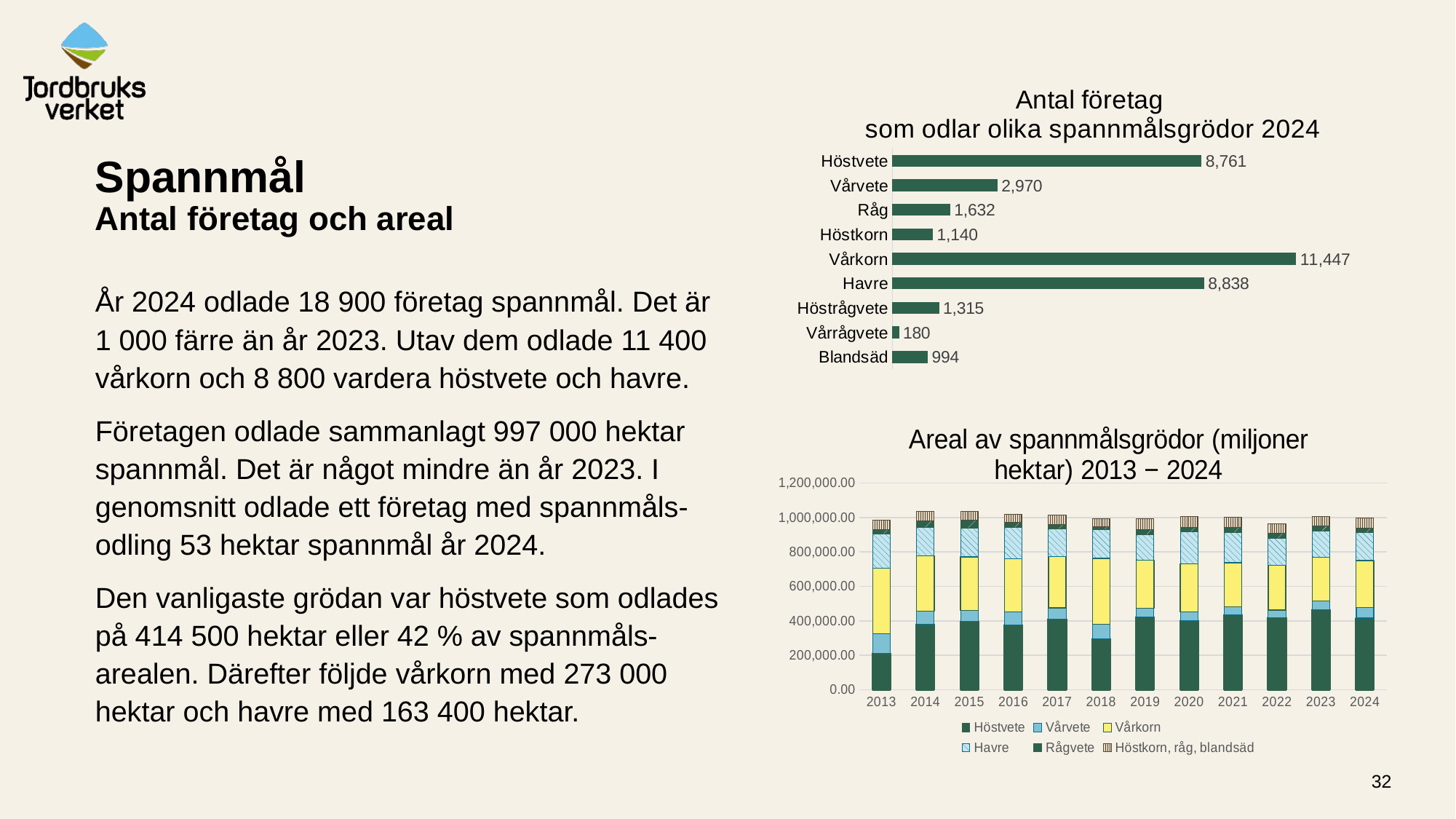
In the chart 'Areal av spannmålsgrödor (miljoner hektar) 2013 − 2024', is the Höstvete value for 2013 greater or less than 400,000.00? less How many crop categories are shown in the chart 'Antal företag som odlar olika spannmålsgrödor 2024'? 9 How many years are shown on the x axis of the chart 'Areal av spannmålsgrödor (miljoner hektar) 2013 − 2024'? 12 In the chart 'Antal företag som odlar olika spannmålsgrödor 2024', what is the value for Höstrågvete? 1,315 In the chart 'Antal företag som odlar olika spannmålsgrödor 2024', which has more companies, Råg or Höstkorn? Råg In the chart 'Antal företag som odlar olika spannmålsgrödor 2024', which crop has the highest number of companies? Vårkorn In the chart 'Antal företag som odlar olika spannmålsgrödor 2024', which crop has the lowest number of companies? Vårrågvete How many series does the legend list in the chart 'Areal av spannmålsgrödor (miljoner hektar) 2013 − 2024'? 6 In the chart 'Antal företag som odlar olika spannmålsgrödor 2024', what is the difference between the values for Havre and Höstvete? 77 In the chart 'Areal av spannmålsgrödor (miljoner hektar) 2013 − 2024', which series is shown in yellow? Vårkorn What type of chart is 'Antal företag som odlar olika spannmålsgrödor 2024'? Bar chart In the chart 'Antal företag som odlar olika spannmålsgrödor 2024', how many companies grow Vårkorn? 11,447